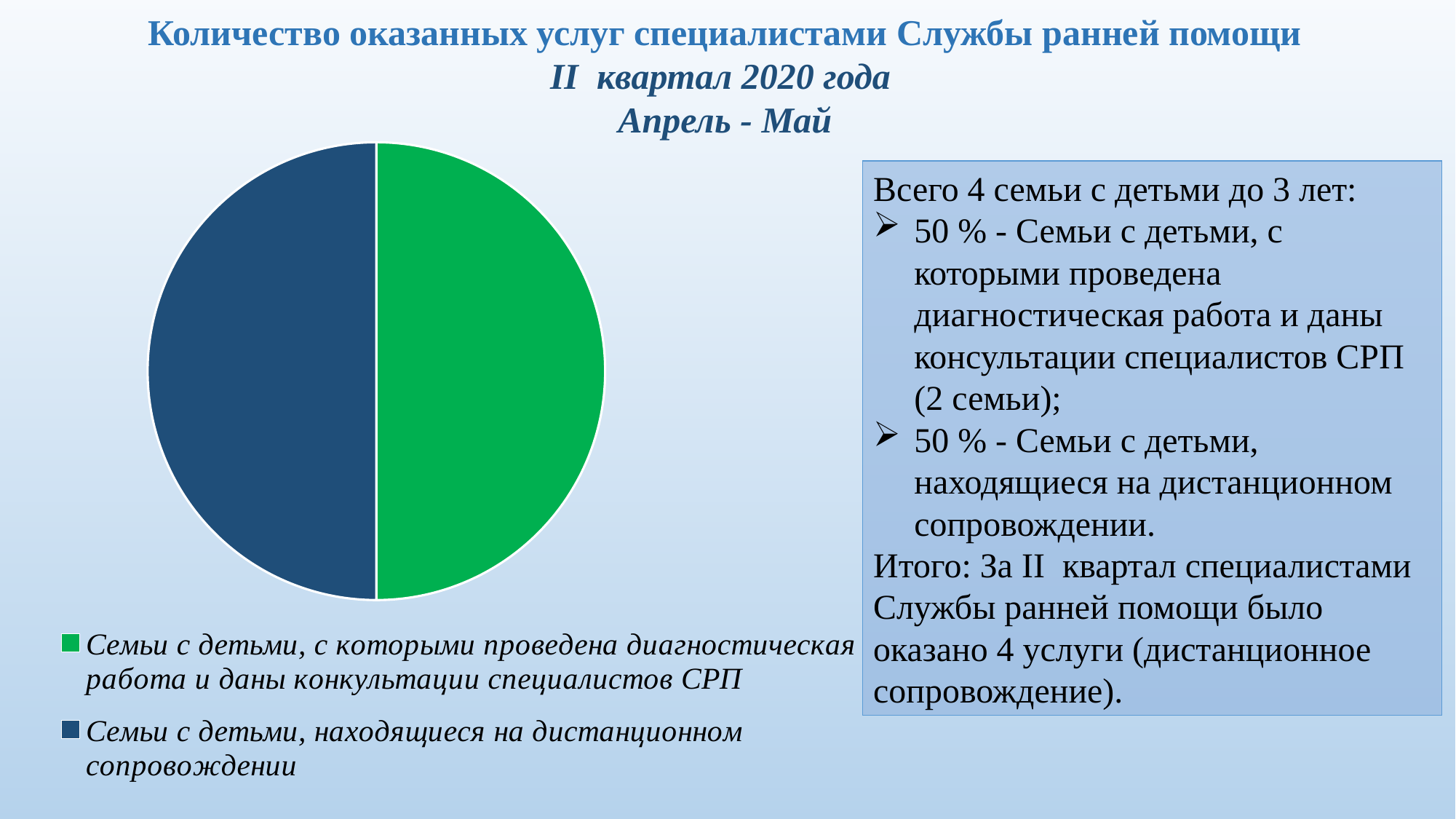
How many entries does the legend of the pie chart list? 2 How many families are in the category "Семьи с детьми, с которыми проведена диагностическая работа и даны конкультации специалистов СРП"? 2 семьи Which colour represents "Семьи с детьми, с которыми проведена диагностическая работа и даны конкультации специалистов СРП" in the pie chart? green What kind of chart is shown on the slide? pie chart How many slices does the pie chart have? 2 What is the total number of families represented in the pie chart? 4 What share of the pie does the slice "Семьи с детьми, с которыми проведена диагностическая работа и даны конкультации специалистов СРП" represent? 50 % What share of the pie does the slice "Семьи с детьми, находящиеся на дистанционном сопровождении" represent? 50 % Which colour represents "Семьи с детьми, находящиеся на дистанционном сопровождении" in the pie chart? dark blue